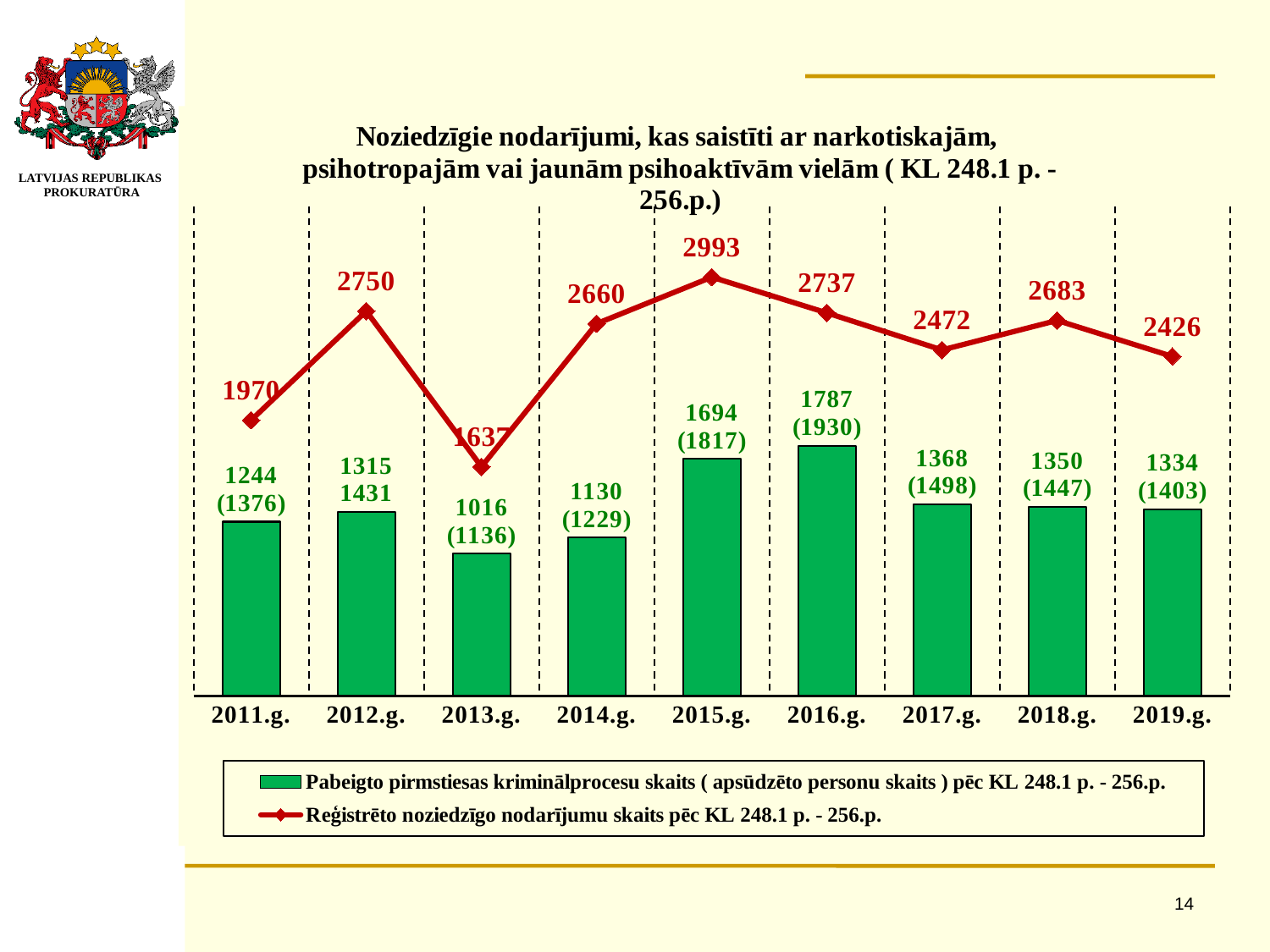
In which year is the green bar of completed pre-trial criminal proceedings the lowest? 2013.g. What is the difference between the registered criminal offences in 2018.g. and 2019.g.? 257 In which year does the red line of registered criminal offences reach its highest value? 2015.g. What kind of chart is shown on the slide? Combined bar and line chart What is the number of completed pre-trial criminal proceedings (green bar) for 2016.g.? 1787 What is the number of accused persons shown in parentheses for 2011.g.? 1376 How many series does the legend list? 2 How many registered criminal offences (Reģistrēto noziedzīgo nodarījumu skaits) are shown for 2015.g.? 2993 Does the number of registered criminal offences rise or fall from 2016.g. to 2017.g.? Fall By how much does the number of completed pre-trial criminal proceedings in 2016.g. exceed that in 2015.g.? 93 Which year has more registered criminal offences, 2012.g. or 2018.g.? 2012.g. How many years are shown on the x axis of the chart? 9